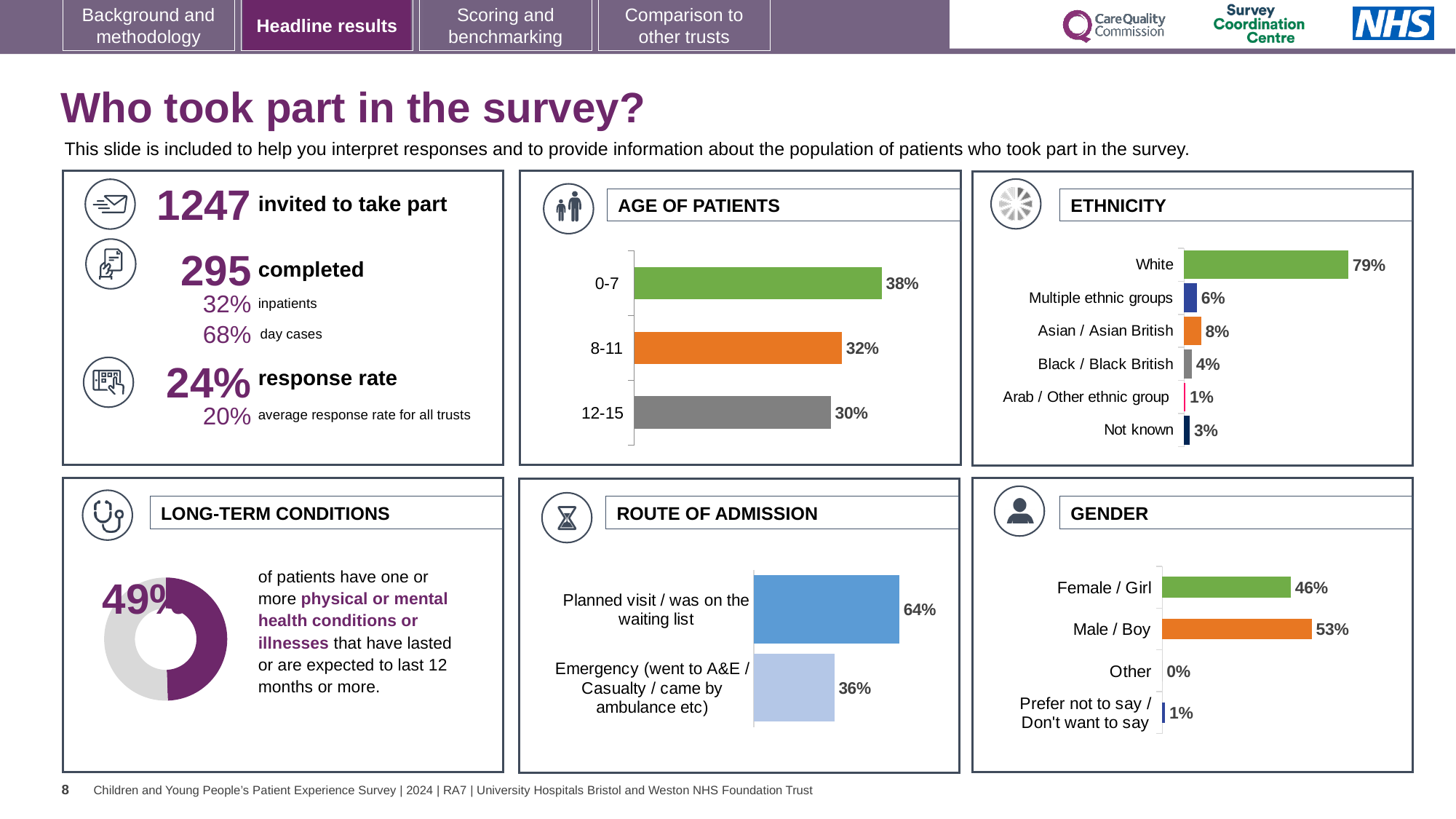
In the ETHNICITY chart, how many categories are shown? 6 In the ETHNICITY chart, what is the value for Asian / Asian British? 8% In the AGE OF PATIENTS chart, what is the difference between the 0-7 and 12-15 values? 8% In the AGE OF PATIENTS chart, which age group has the highest value? 0-7 In the ROUTE OF ADMISSION chart, what is the difference between the Planned visit and Emergency values? 28% In the ROUTE OF ADMISSION chart, what is the value for Emergency (went to A&E / Casualty / came by ambulance etc)? 36% In the AGE OF PATIENTS chart, what is the value for the 8-11 age group? 32% In the GENDER chart, which category has the highest value? Male / Boy In the ETHNICITY chart, which is larger: Multiple ethnic groups or Black / Black British? Multiple ethnic groups What kind of chart is used in the LONG-TERM CONDITIONS panel? Doughnut chart In the ETHNICITY chart, which category has the lowest value? Arab / Other ethnic group In the GENDER chart, what is the value for Male / Boy? 53%